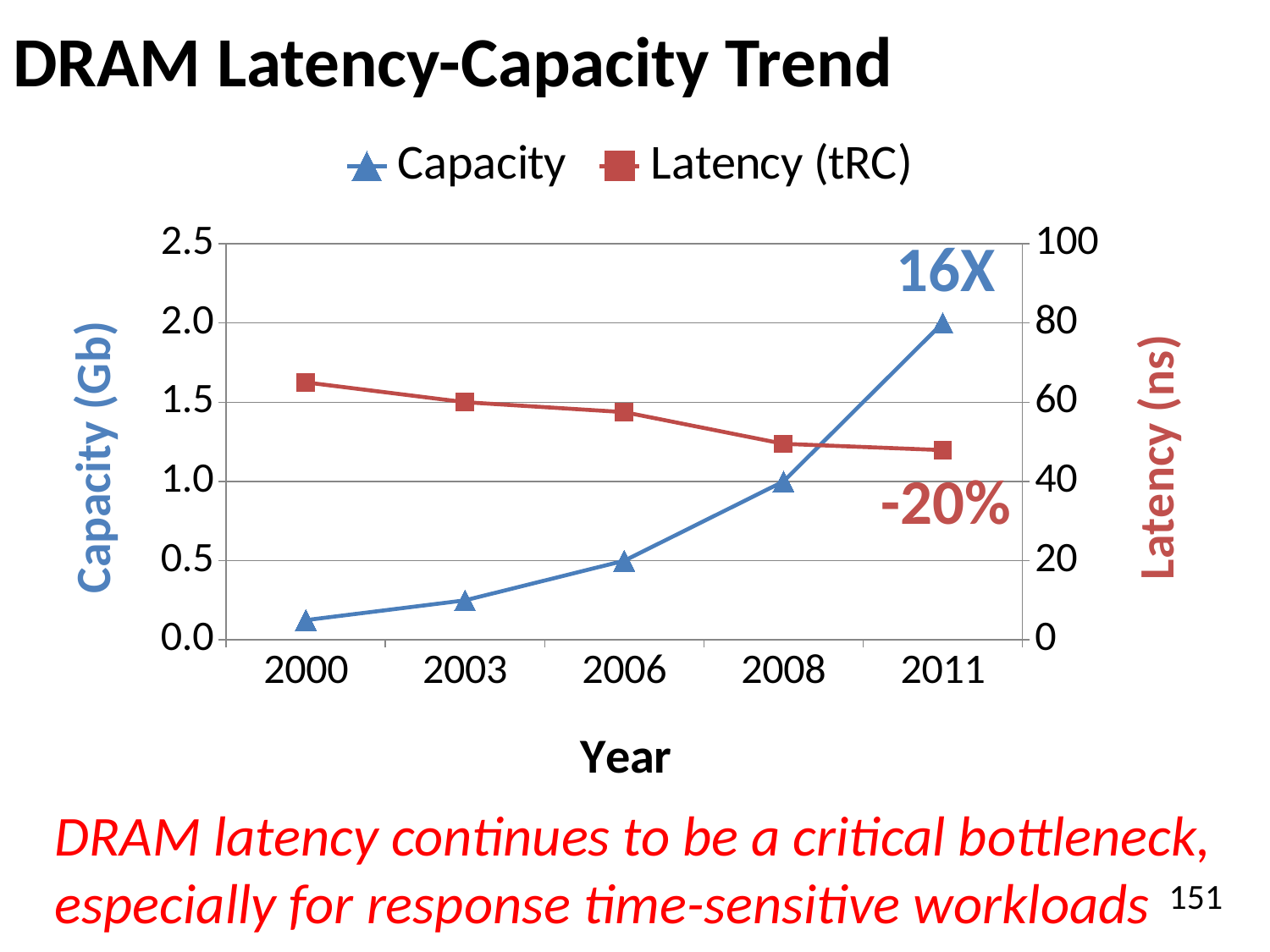
Is the Capacity value for 2006 greater or less than 1.0? less In which year is Latency (tRC) highest? 2000 Is the Latency (tRC) value for 2011 greater or less than 60? less What annotation is printed next to the Capacity line at 2011? 16X How many series does the legend list? 2 What is the Capacity value for 2011? 2.0 In which year is Capacity highest? 2011 How many years are plotted along the x axis? 5 Does the Capacity series rise or fall from 2000 to 2011? rise Does the Latency (tRC) series rise or fall from 2000 to 2011? fall What kind of chart is shown on the slide? line chart What is the Capacity value for 2008? 1.0